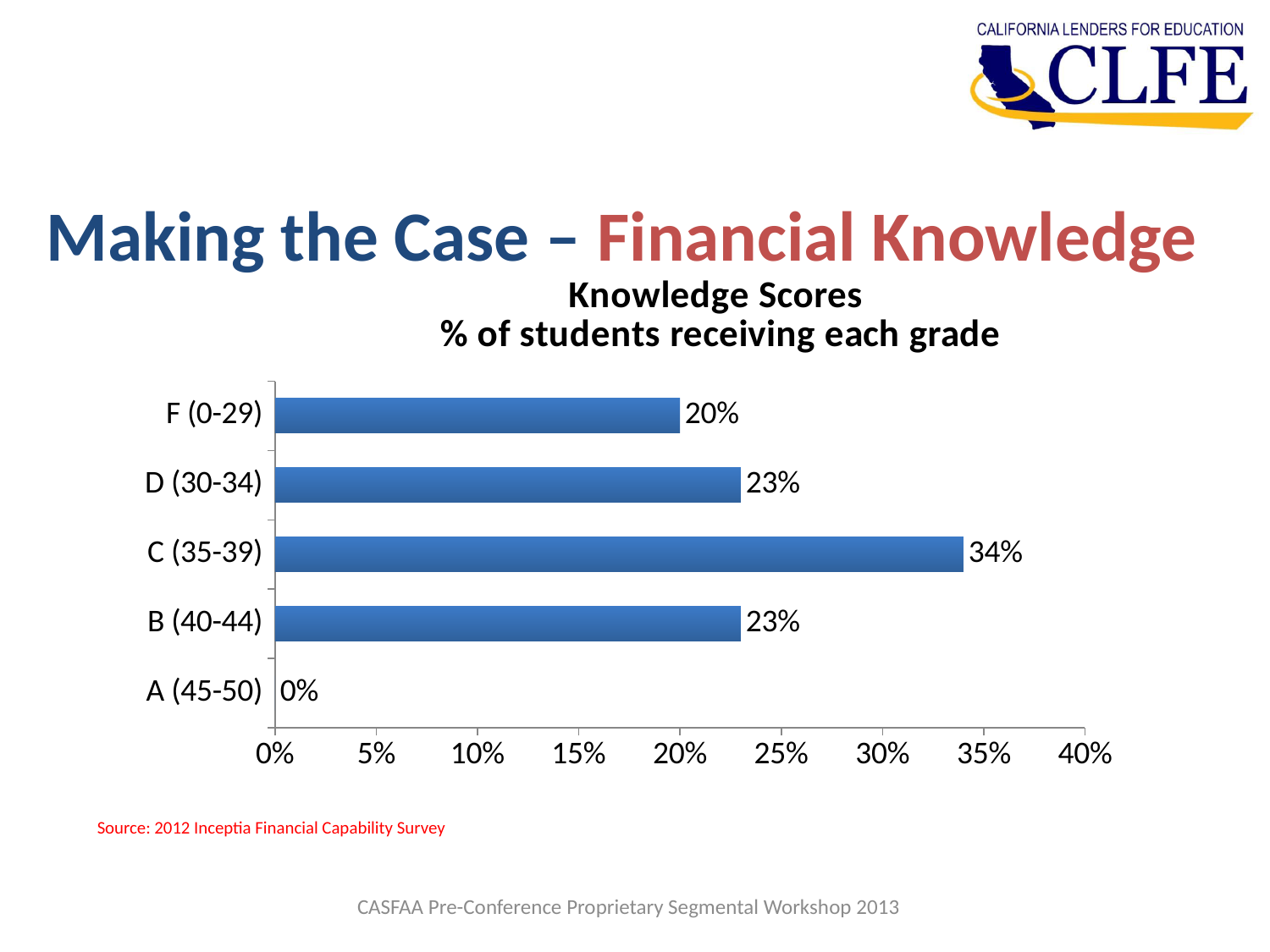
How many grade categories are shown in the chart? 5 What percentage of students received an A (45-50) grade? 0% Which is larger: the percentage of students receiving a D (30-34) or an F (0-29)? D (30-34) Is the value for C (35-39) greater or less than 30%? greater What percentage of students received a C (35-39) grade? 34% What is the title of the chart? Knowledge Scores % of students receiving each grade What is the difference between the percentage of students receiving a C (35-39) and those receiving an F (0-29)? 14% What kind of chart is shown on the slide? bar chart What is the maximum value shown on the horizontal axis? 40% Which grade category has the highest percentage of students? C (35-39) What percentage of students received an F (0-29) grade? 20% Which grade category has the lowest percentage of students? A (45-50)